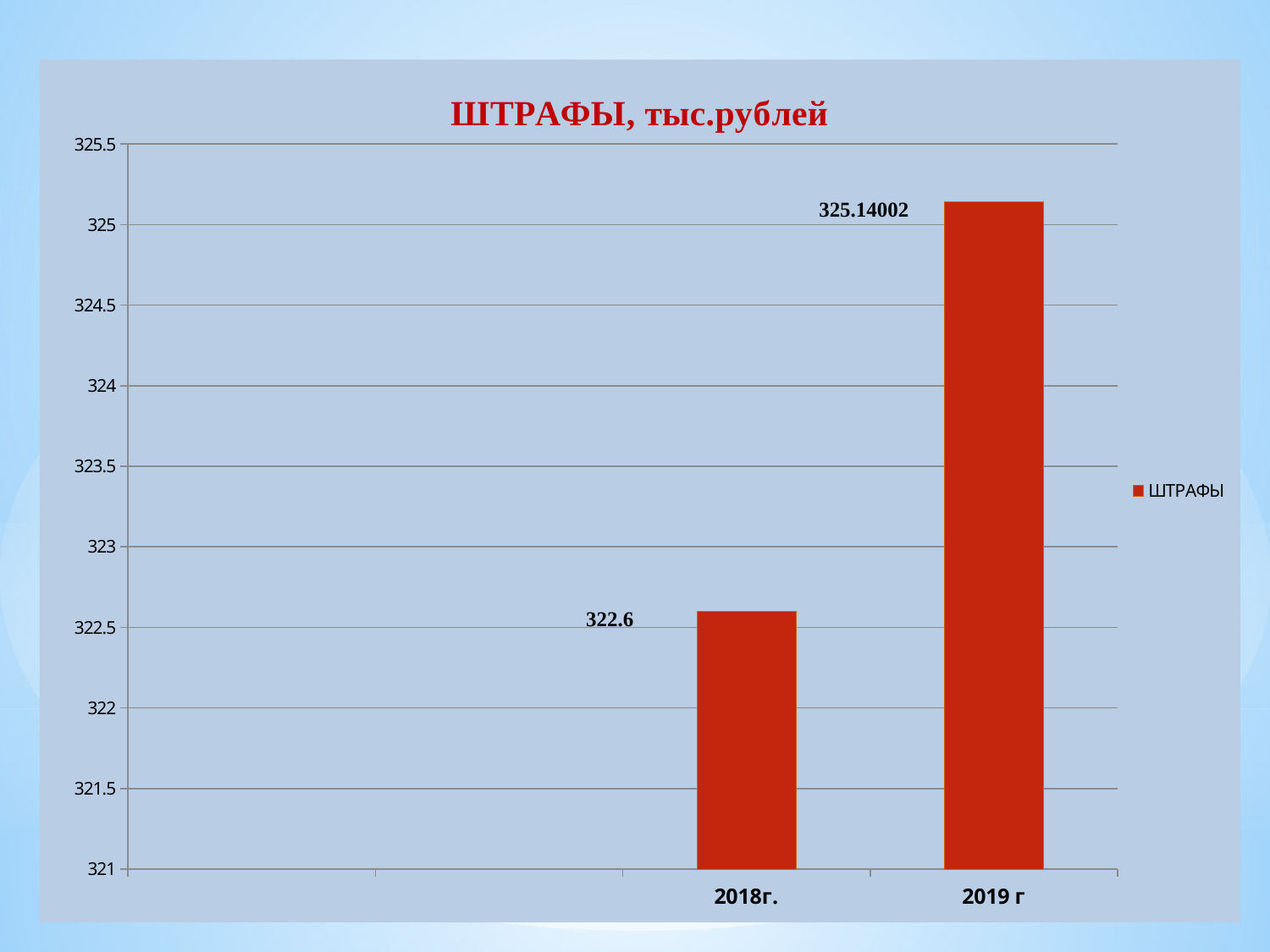
How many series does the legend list? 1 What is the value for 2018г.? 322.6 Which year has the highest value? 2019 г How many categories are shown on the x axis? 2 Is the value for 2019 г greater or less than 325? greater What is the difference between the values for 2019 г and 2018г.? 2.54002 Which year has the lowest value? 2018г. Which is larger, the value for 2018г. or the value for 2019 г? 2019 г What is the value for 2019 г? 325.14002 What is the title of the chart? ШТРАФЫ, тыс.рублей Is the value for 2018г. greater or less than 323? less What kind of chart is shown on the slide? bar chart